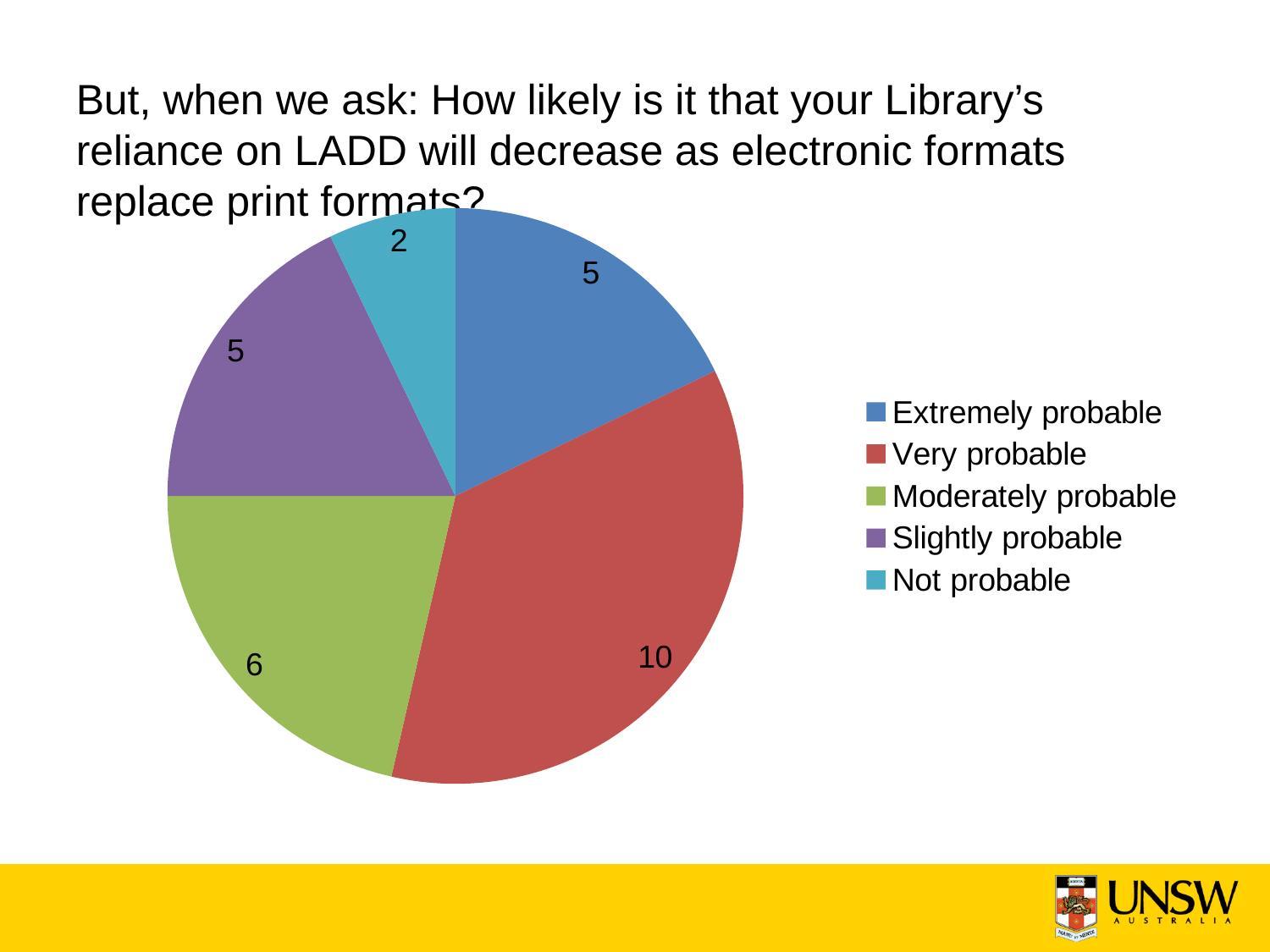
What is the value shown for 'Not probable'? 2 Which is larger, the 'Moderately probable' slice or the 'Slightly probable' slice? Moderately probable Which category has the smallest slice of the pie? Not probable What colour is the 'Very probable' slice? Red What is the difference between the 'Very probable' and 'Moderately probable' values? 4 What is the total of all the slice values in the pie chart? 28 How many responses are in the 'Very probable' slice? 10 How many categories does the pie chart have? 5 What type of chart is shown on the slide? Pie chart What is the value shown for 'Moderately probable'? 6 Which category has the largest slice of the pie? Very probable What is the value shown for 'Extremely probable'? 5